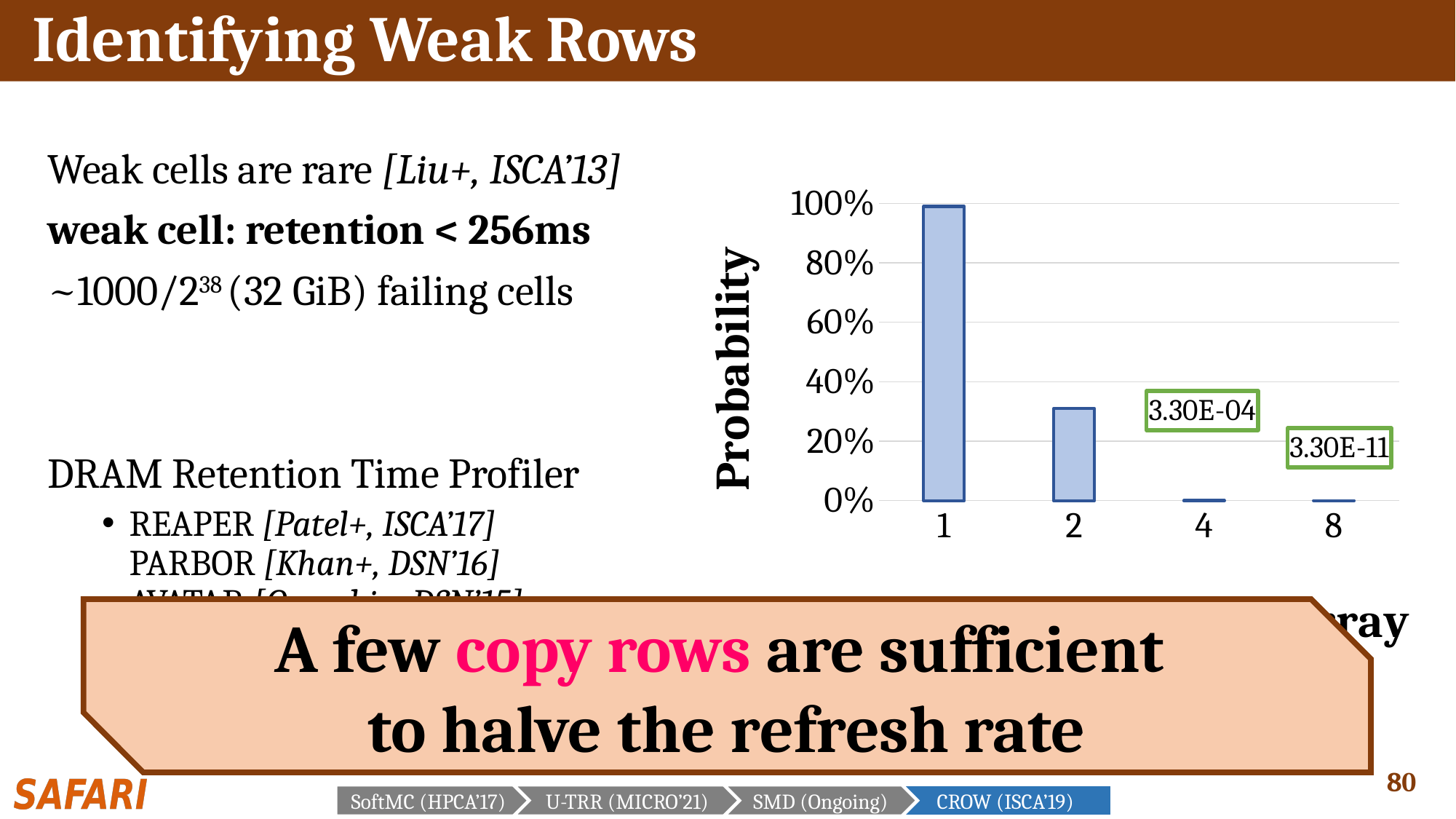
Which category has the highest probability? 1 Is the probability for category 1 greater or less than 80%? greater Which category has the lowest probability? 8 What is the probability value labelled for category 4? 3.30E-04 Is the probability for category 2 greater or less than 20%? greater Which has the larger probability, category 1 or category 2? 1 What is the probability value labelled for category 8? 3.30E-11 What is the title of the y axis of the chart? Probability How many bars (categories) are plotted on the x axis of the chart? 4 What kind of chart is shown on the slide? bar chart Do the probability values rise or fall as the x-axis category increases from 1 to 8? fall Is the probability for category 2 greater or less than 40%? less